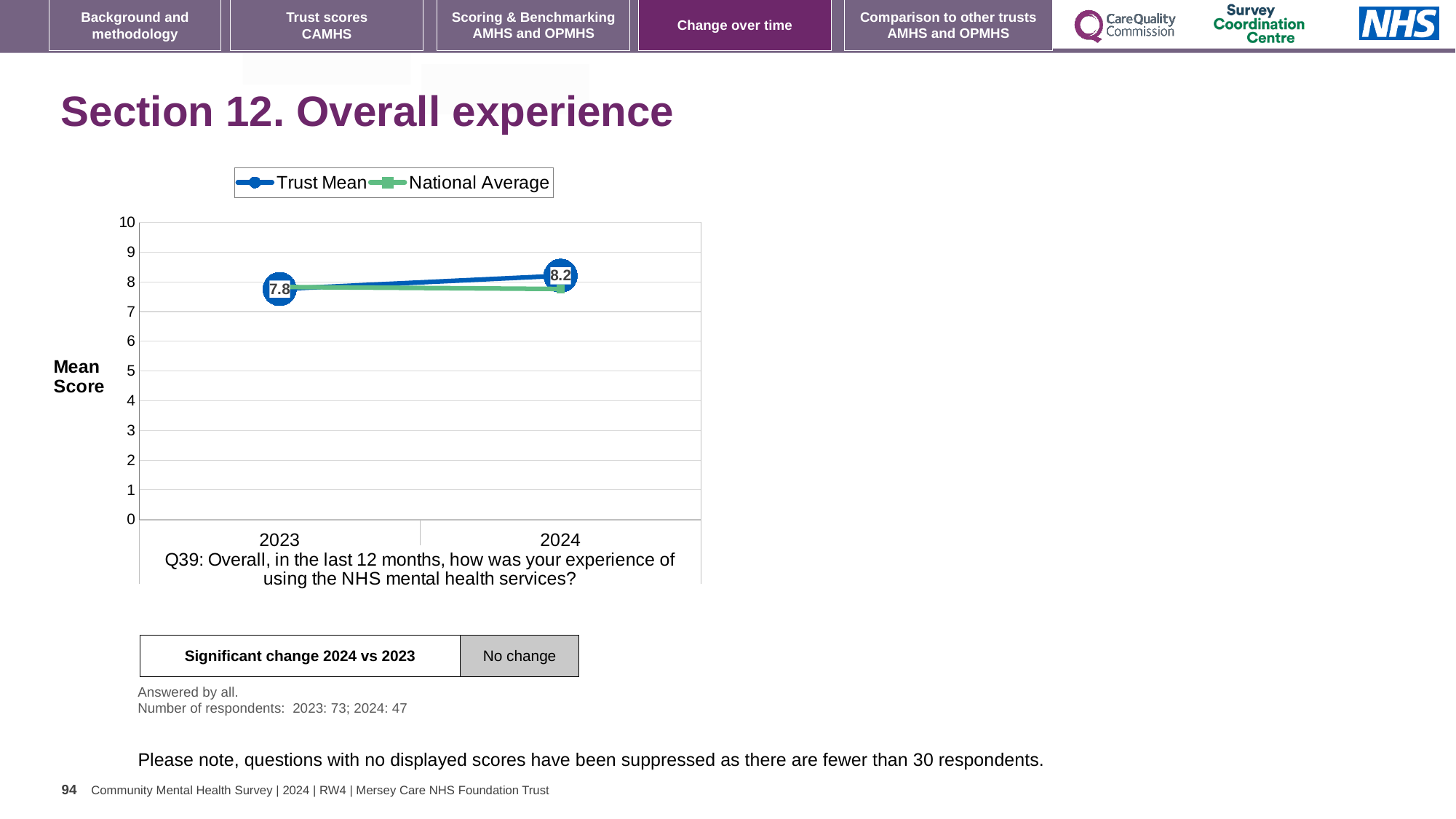
Is the National Average value for 2023 greater or less than 9? less What type of chart is shown on the slide? line chart Does the Trust Mean score rise or fall from 2023 to 2024? rise In 2024, which is larger: the Trust Mean or the National Average? Trust Mean By how much did the Trust Mean score change from 2023 to 2024? 0.4 How many series does the chart legend list? 2 What is the Trust Mean score for 2024? 8.2 What is the Trust Mean score for 2023? 7.8 In which year is the Trust Mean score lowest? 2023 In which year is the Trust Mean score highest? 2024 How many years are shown on the x axis of the chart? 2 Is the National Average value for 2024 greater or less than 5? greater